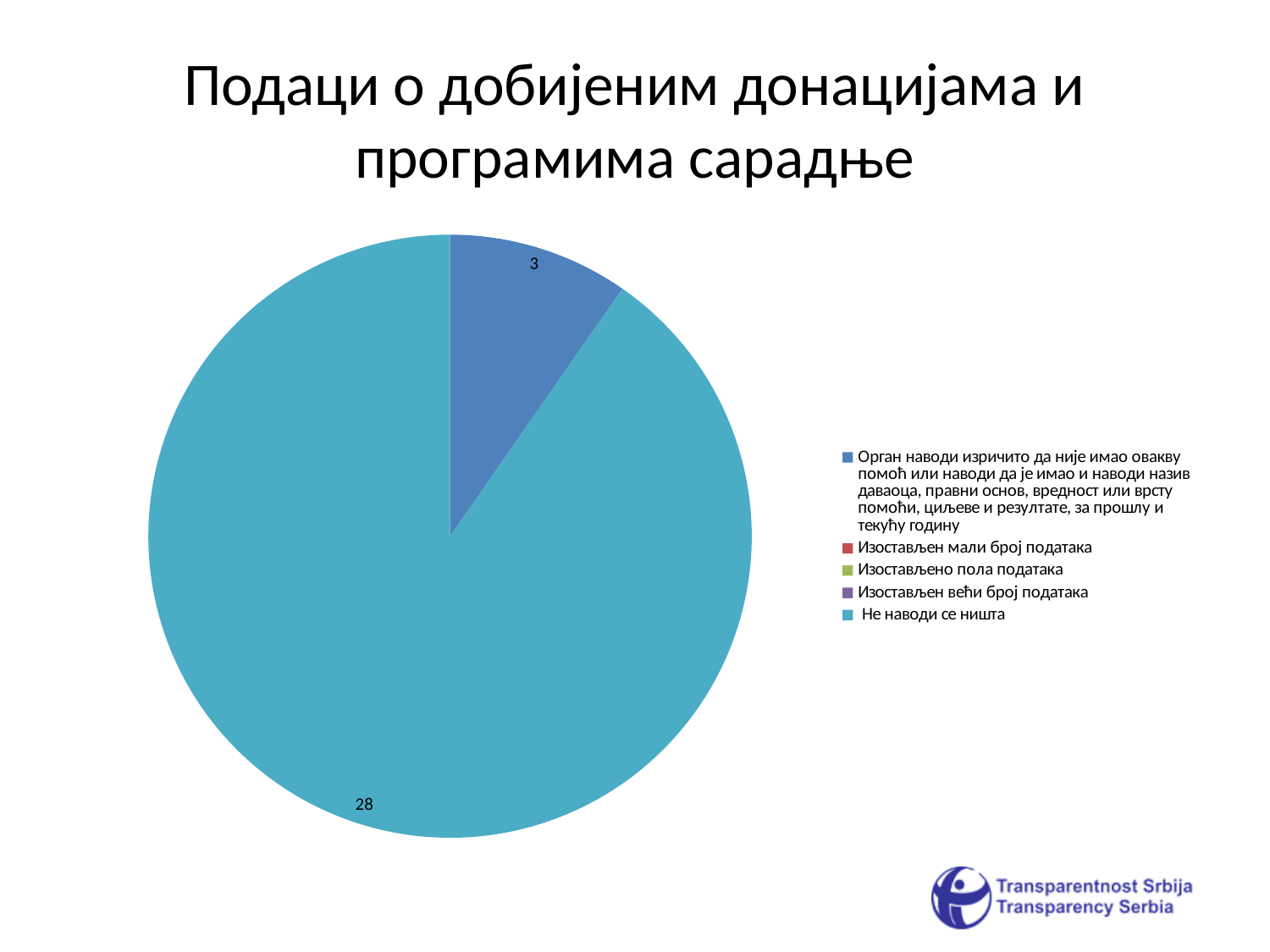
What kind of chart is shown on the slide? pie chart What is the value of the dark blue slice (the first legend entry, "Орган наводи изричито да није имао овакву помоћ...")? 3 What is the difference between the value of the "Не наводи се ништа" slice and the dark blue slice? 25 What is the title of the slide containing the pie chart? Подаци о добијеним донацијама и програмима сарадње What is the value of the slice labelled "Не наводи се ништа"? 28 Which of the two visible slices is smaller, the one labelled 3 or the one labelled 28? the one labelled 3 Which category has the largest slice in the pie chart? Не наводи се ништа What colour is the slice labelled 28? teal (light blue) Is the value for "Не наводи се ништа" larger or smaller than the value for the dark blue slice? larger How many entries does the legend list? 5 How many slices with data labels are visible in the pie chart? 2